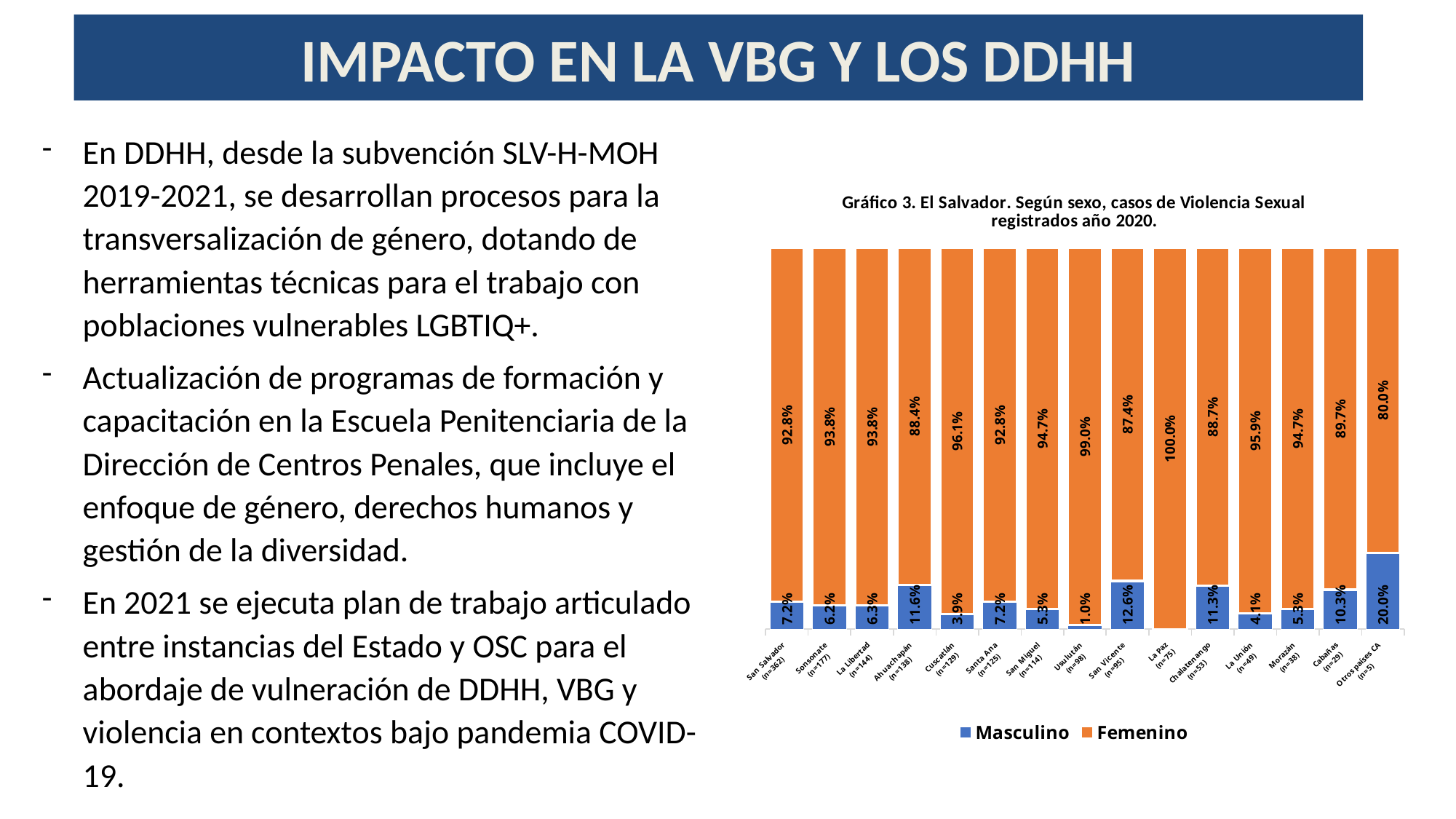
What is the Femenino value for San Salvador? 92.8% Which colour represents the Femenino series in the chart? Orange Which category has the highest Femenino share? La Paz What is the difference between the Masculino values for San Vicente and Cuscatlán? 8.7% What kind of chart is shown on the slide? Stacked bar chart Which category has the lowest Femenino share? Otros países CA Which category has the highest Masculino share? Otros países CA What is the Masculino value for Usulután? 1.0% Which is larger, the Masculino value for Chalatenango or for Cabañas? Chalatenango How many categories are shown on the x axis? 15 What is the Masculino value for Ahuachapán? 11.6% How many series does the legend list? 2